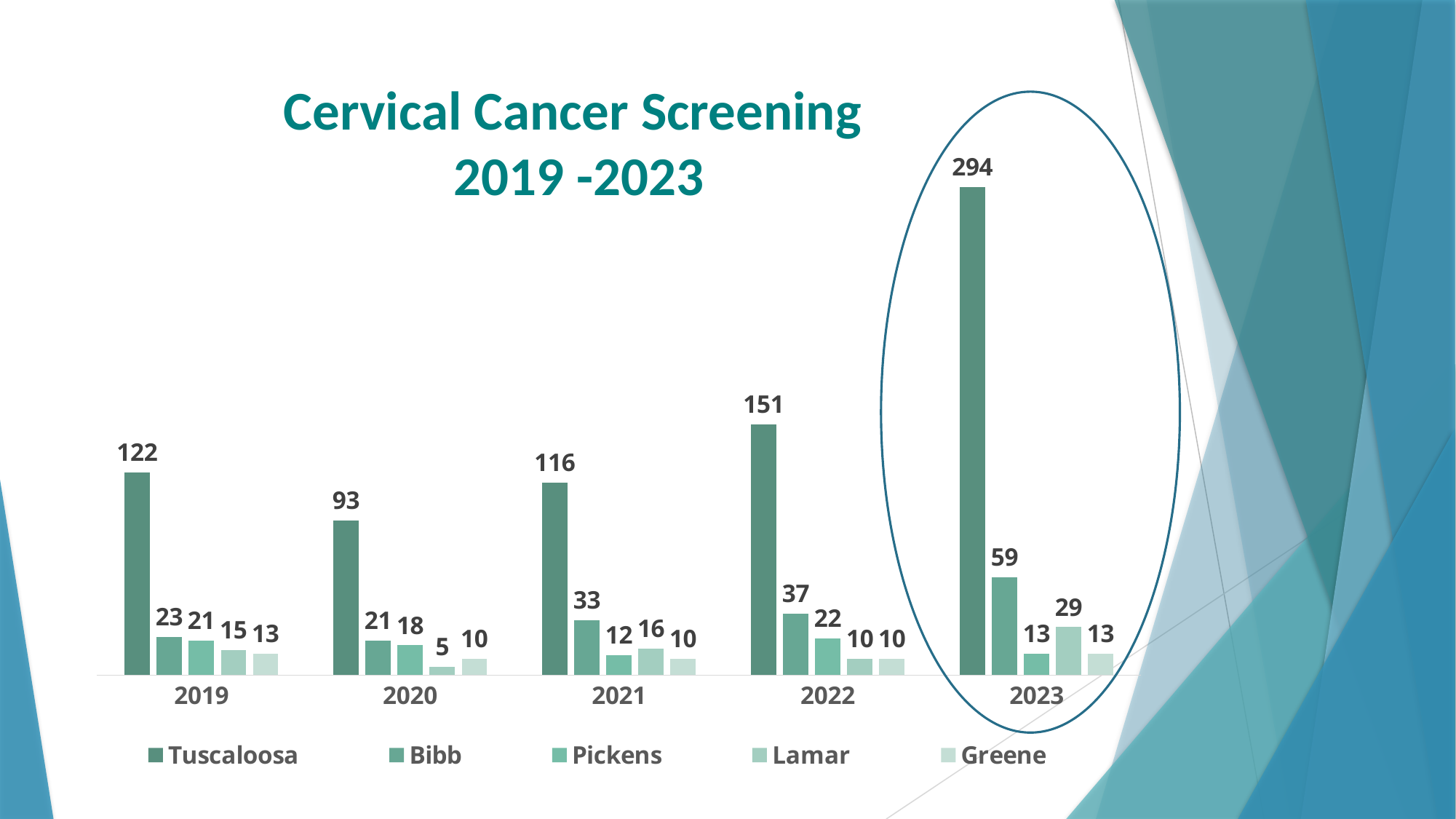
What is the value for Tuscaloosa in 2023? 294 Does the Bibb value rise or fall from 2021 to 2023? Rise What is the value for Bibb in 2022? 37 What is the difference between the Tuscaloosa values for 2023 and 2022? 143 Which is larger, the Pickens value in 2021 or the Lamar value in 2021? Lamar How many years are shown on the x axis? 5 How many series does the legend list? 5 What kind of chart is shown on the slide? Bar chart In which year is the Tuscaloosa value lowest? 2020 What is the title of the chart? Cervical Cancer Screening 2019 -2023 What is the value for Lamar in 2020? 5 In which year is the Tuscaloosa value highest? 2023